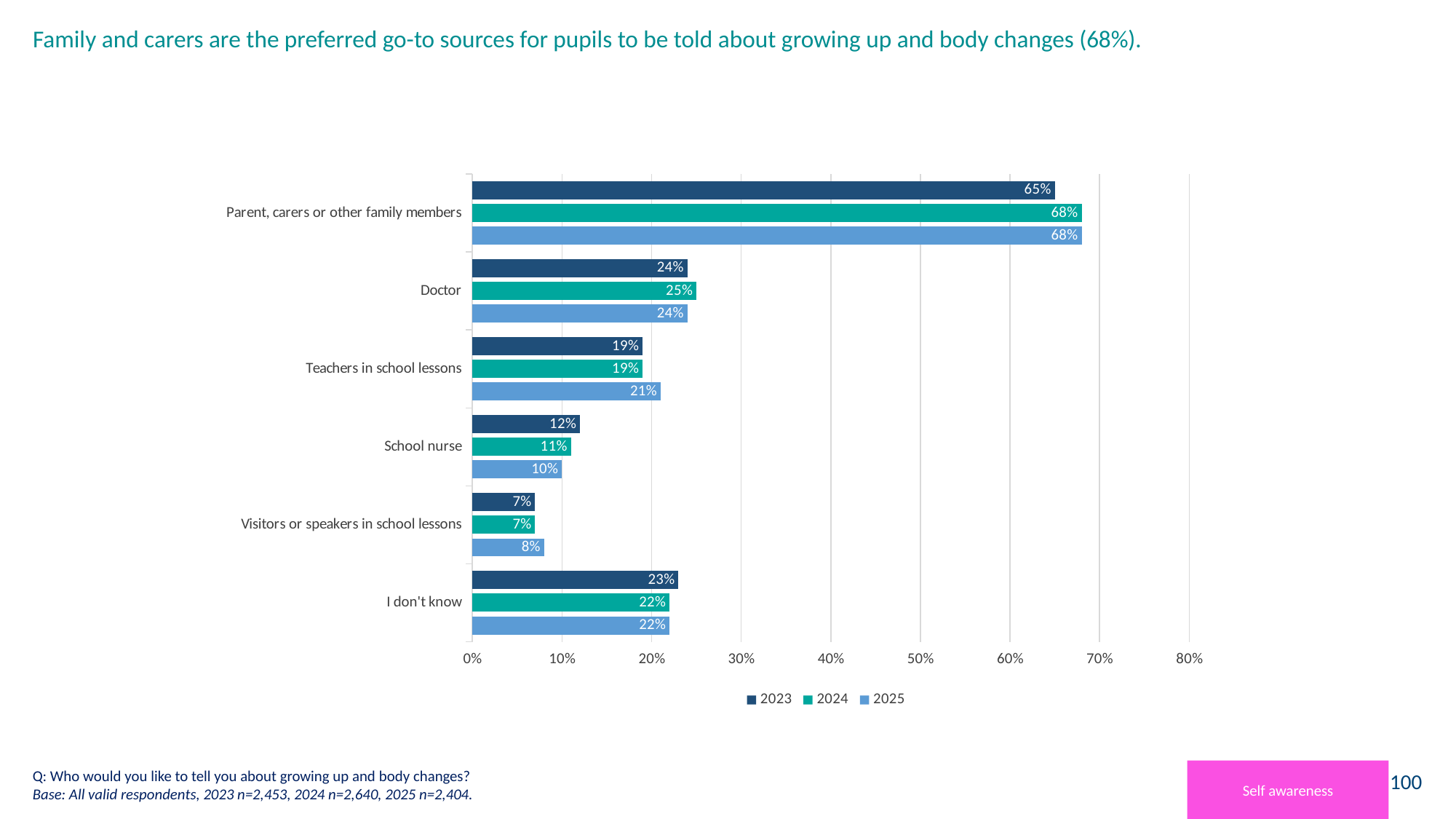
What is the 2025 value for Teachers in school lessons? 21% What kind of chart is shown on the slide? Bar chart What is the 2025 value for Parent, carers or other family members? 68% Which category has the highest value in 2024? Parent, carers or other family members How many categories are shown on the chart? 6 How many series does the legend list? 3 What is the difference between the 2025 and 2023 values for Parent, carers or other family members? 3% Which category has the lowest value in 2023? Visitors or speakers in school lessons What is the 2024 value for School nurse? 11% What is the 2023 value for Doctor? 24% Which years are listed in the legend? 2023, 2024, 2025 Which is larger: the 2023 value for I don't know or the 2023 value for Doctor? Doctor